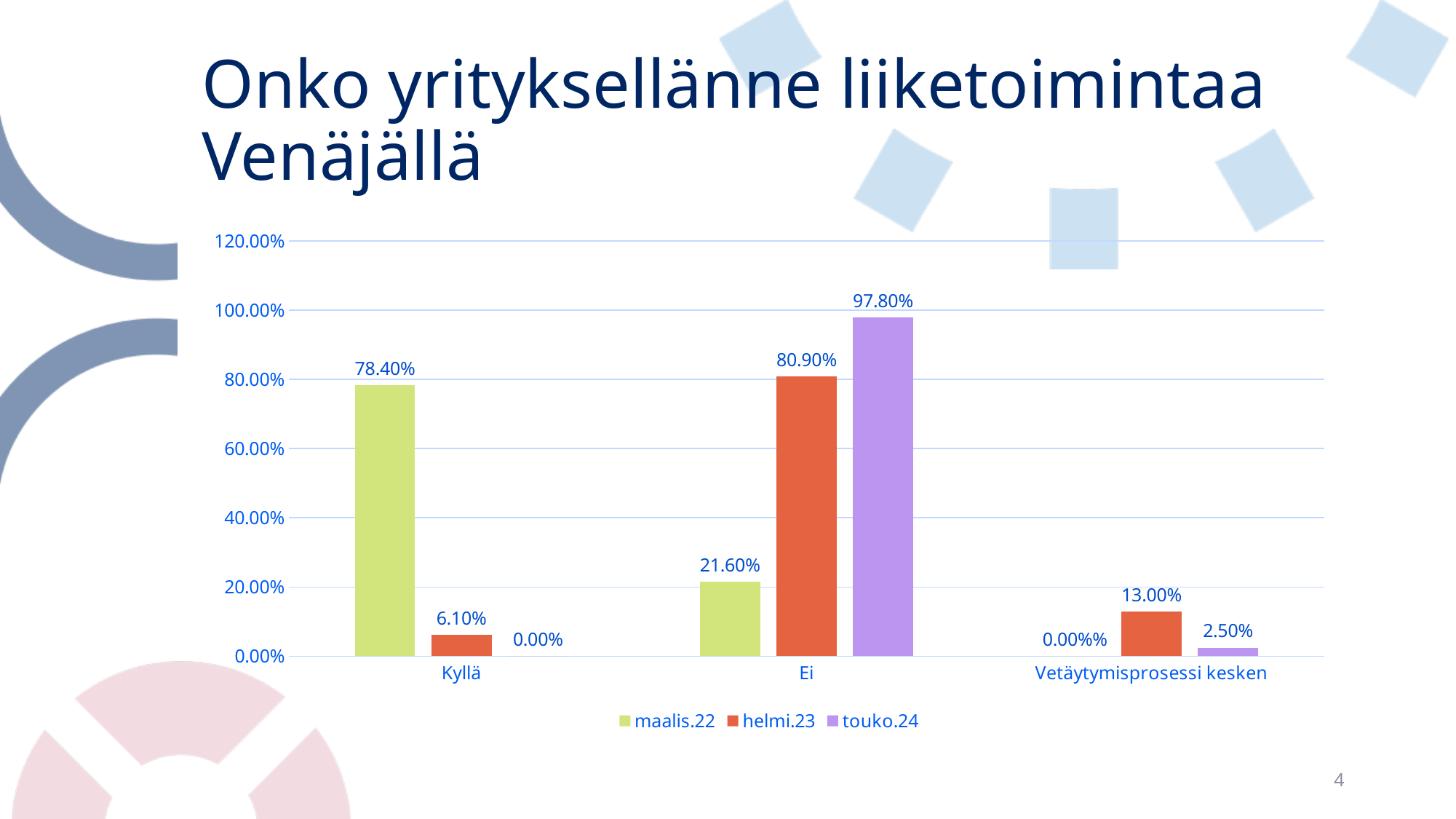
What is the value for Kyllä in the maalis.22 series? 78.40% How many categories are shown on the x axis? 3 What is the value for Kyllä in the helmi.23 series? 6.10% What is the value for Ei in the touko.24 series? 97.80% What is the difference between the helmi.23 and maalis.22 values for Ei? 59.30% Which category has the lowest value in the maalis.22 series? Vetäytymisprosessi kesken How many series does the legend list? 3 What is the value for Vetäytymisprosessi kesken in the helmi.23 series? 13.00% What kind of chart is shown on the slide? bar chart What is the title of the slide? Onko yrityksellänne liiketoimintaa Venäjällä Which category has the highest value in the touko.24 series? Ei Which is larger for Kyllä: the maalis.22 value or the helmi.23 value? maalis.22